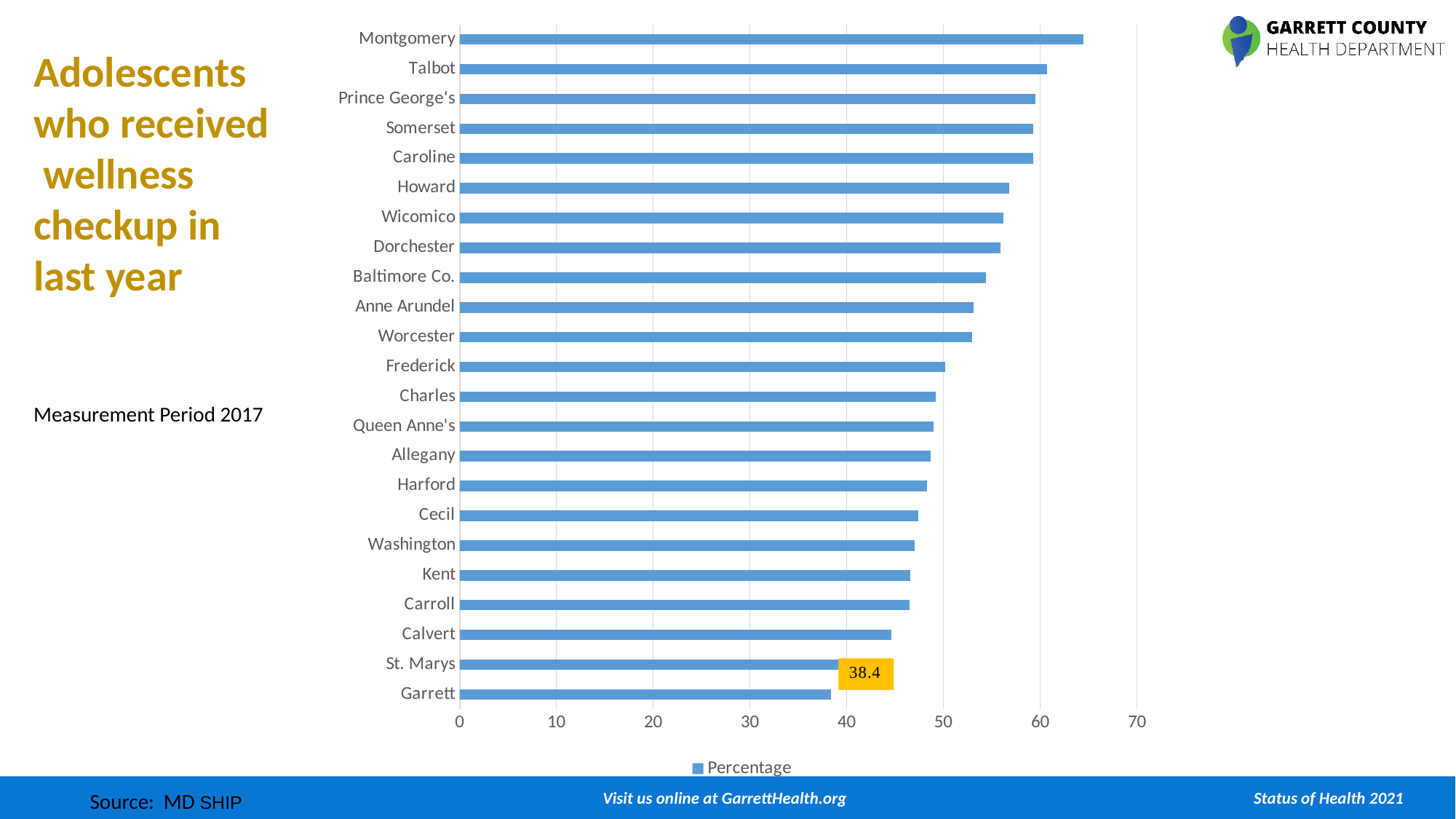
Is the value for Montgomery greater or less than 60? greater Is the value for Howard greater or less than 50? greater Is the value for Garrett greater or less than 40? less Which county has the lowest value? Garrett What is the name of the series shown in the legend? Percentage Which is larger, the value for Talbot or the value for Kent? Talbot What kind of chart is shown on the slide? bar chart What is the value for Garrett? 38.4 How many counties are shown in the chart? 23 Which county has the highest value? Montgomery How many series does the legend list? 1